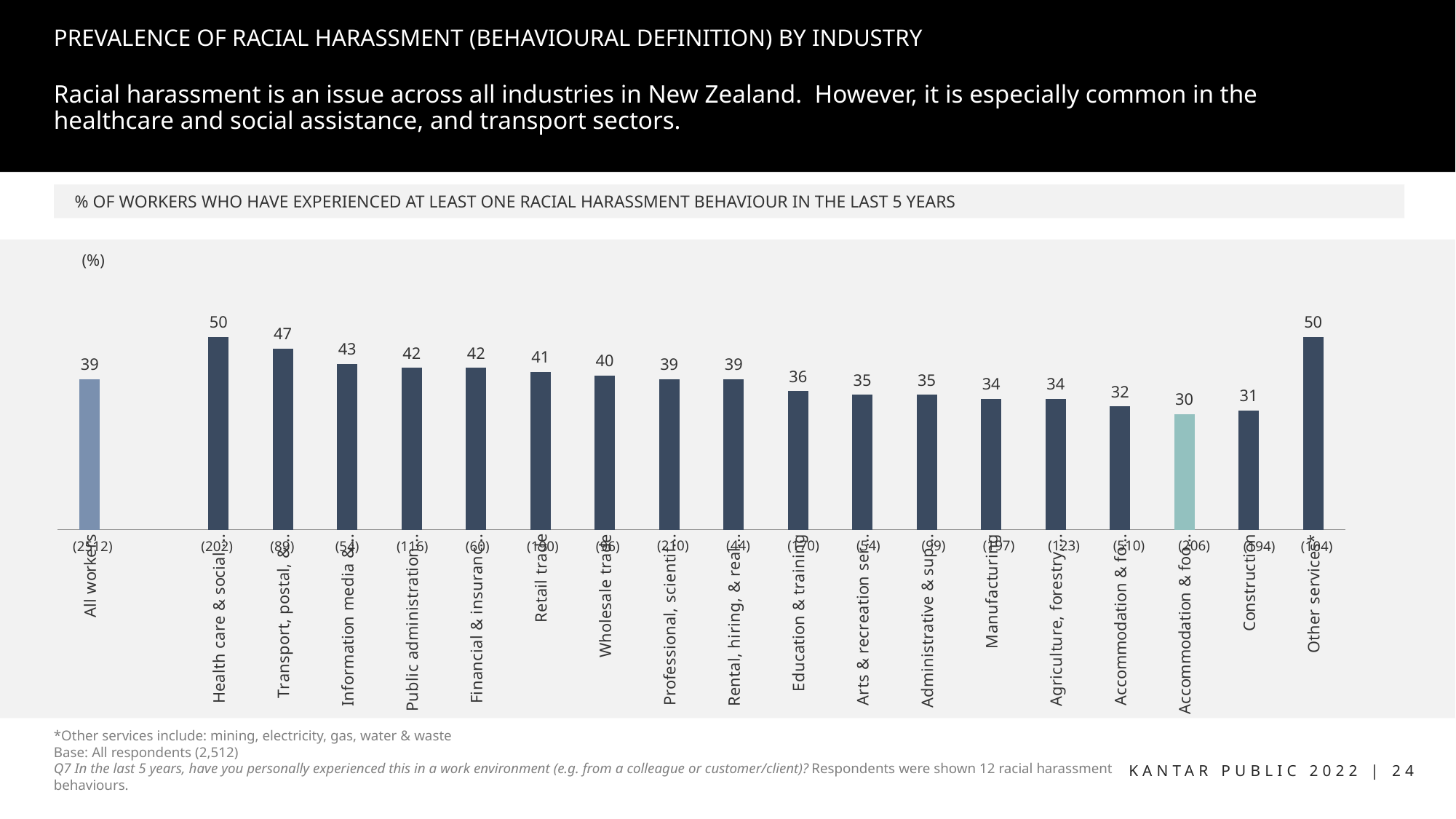
What is the value for Construction? 31 What is the value for Education & training? 36 What is the base size shown for All workers? (2,512) What is the value for Manufacturing? 34 What is the value for Retail trade? 41 What kind of chart is shown on the slide? Bar chart What is the value for All workers? 39 What is the lowest value shown on the chart? 30 What is the value for Wholesale trade? 40 How many bars are plotted on the chart? 19 What is the difference between the value for Retail trade and the value for Construction? 10 Which is larger, the value for Wholesale trade or the value for Manufacturing? Wholesale trade